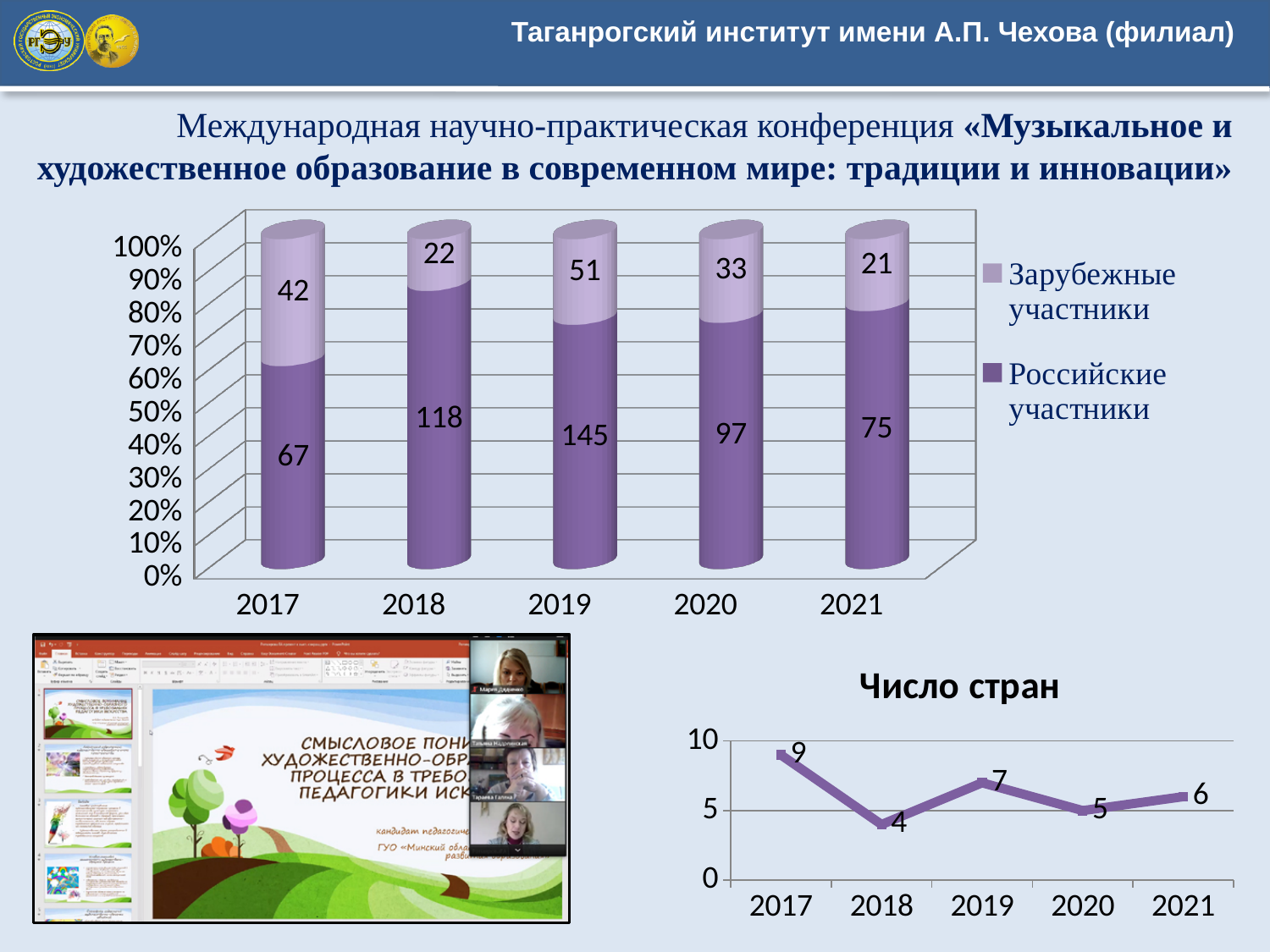
In the top stacked bar chart, were there more Зарубежные участники in 2019 or in 2020? 2019 In the chart titled 'Число стран', which year has the highest value? 2017 In the top stacked bar chart, what is the difference between the number of Российские участники in 2019 and in 2021? 70 In the top stacked bar chart, which year had the lowest number of Зарубежные участники? 2021 How many series does the legend of the top stacked bar chart list? 2 What kind of chart is the chart titled 'Число стран'? line chart In the top stacked bar chart, which year had the highest number of Российские участники? 2019 How many years are shown on the x axis of the top stacked bar chart? 5 In the top stacked bar chart, what is the total number of participants (Российские plus Зарубежные) in 2018? 140 In the chart titled 'Число стран', what is the value for 2018? 4 In the top stacked bar chart, how many Российские участники were there in 2019? 145 In the top stacked bar chart, how many Зарубежные участники were there in 2017? 42